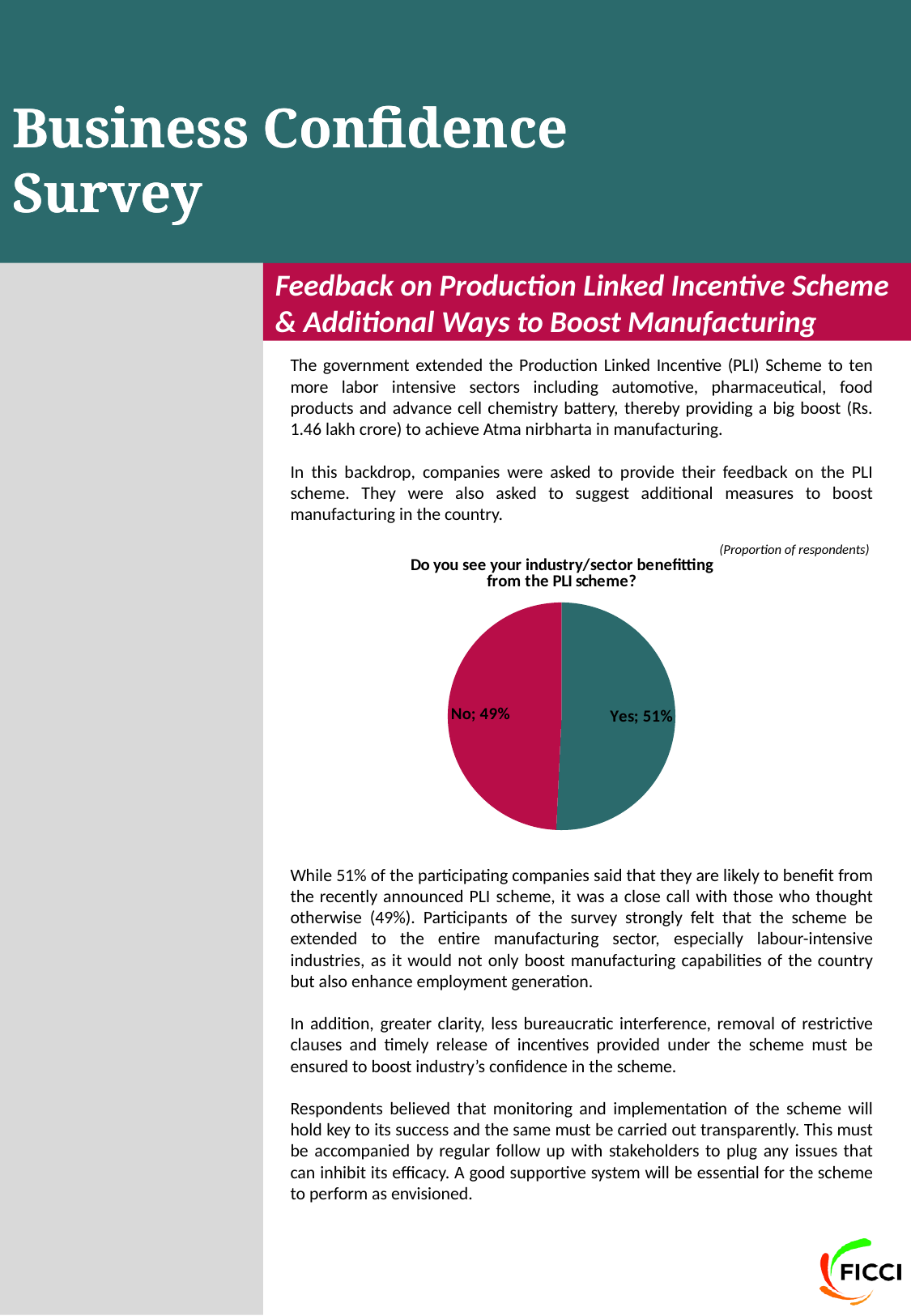
What kind of chart is shown on the slide? Pie chart What colour is the No slice in the pie chart? Magenta/crimson What is the difference in percentage points between the Yes and No slices? 2 percentage points What is the title of the pie chart? Do you see your industry/sector benefitting from the PLI scheme? Which slice of the pie chart is the largest? Yes What do the Yes and No slices add up to in the pie chart? 100% What share of respondents answered No in the pie chart? 49% What share of respondents answered Yes in the pie chart? 51% Which is larger in the pie chart, the Yes slice or the No slice? Yes Is the share for Yes greater or less than 50%? greater How many slices does the pie chart have? 2 Which slice of the pie chart is the smallest? No